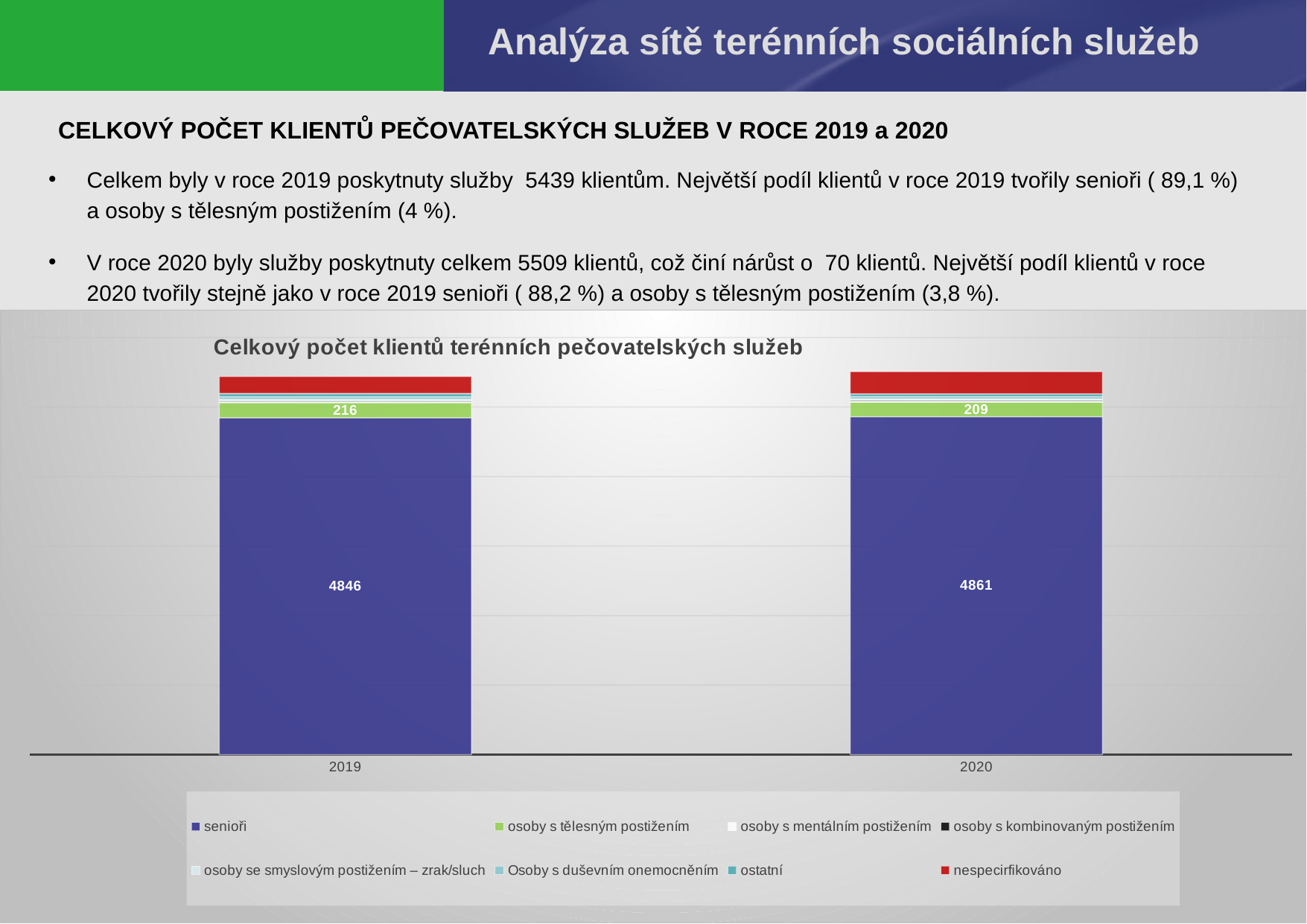
By how much did the value for senioři change from 2019 to 2020? 15 How many years (categories) are shown on the x axis? 2 What is the value for osoby s tělesným postižením in 2019? 216 What kind of chart is shown on the slide? stacked bar chart What is the value for osoby s tělesným postižením in 2020? 209 Which series makes up the largest part of the 2019 bar? senioři How many series does the legend list? 8 Which year has the larger value for osoby s tělesným postižením, 2019 or 2020? 2019 What is the value for senioři in 2019? 4846 Which year has the larger value for senioři, 2019 or 2020? 2020 What is the value for senioři in 2020? 4861 What is the difference between the values for osoby s tělesným postižením in 2019 and 2020? 7